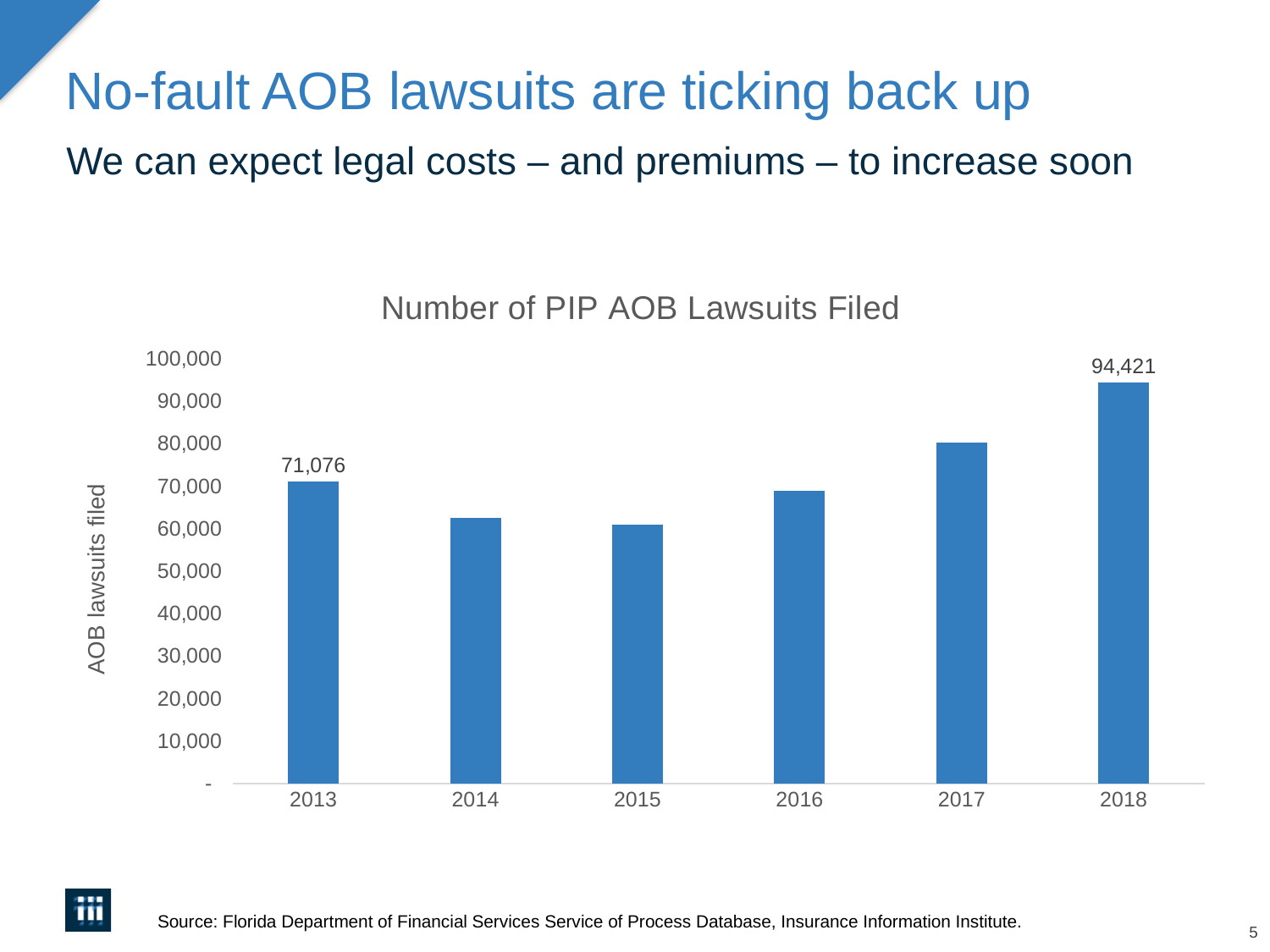
What kind of chart is used to show the number of PIP AOB lawsuits filed? Bar chart What is the difference between the number of lawsuits filed in 2018 and in 2013? 23,345 How many years are shown on the x axis of the chart? 6 Is the value for 2017 greater or less than 70,000? greater Do the values rise or fall from 2015 to 2018? Rise What is the title of the chart? Number of PIP AOB Lawsuits Filed What is the number of PIP AOB lawsuits filed in 2018? 94,421 Which year has the highest number of PIP AOB lawsuits filed? 2018 Which year had more PIP AOB lawsuits filed, 2013 or 2015? 2013 What is the number of PIP AOB lawsuits filed in 2013? 71,076 Is the value for 2015 greater or less than 70,000? less Which year had more PIP AOB lawsuits filed, 2016 or 2017? 2017